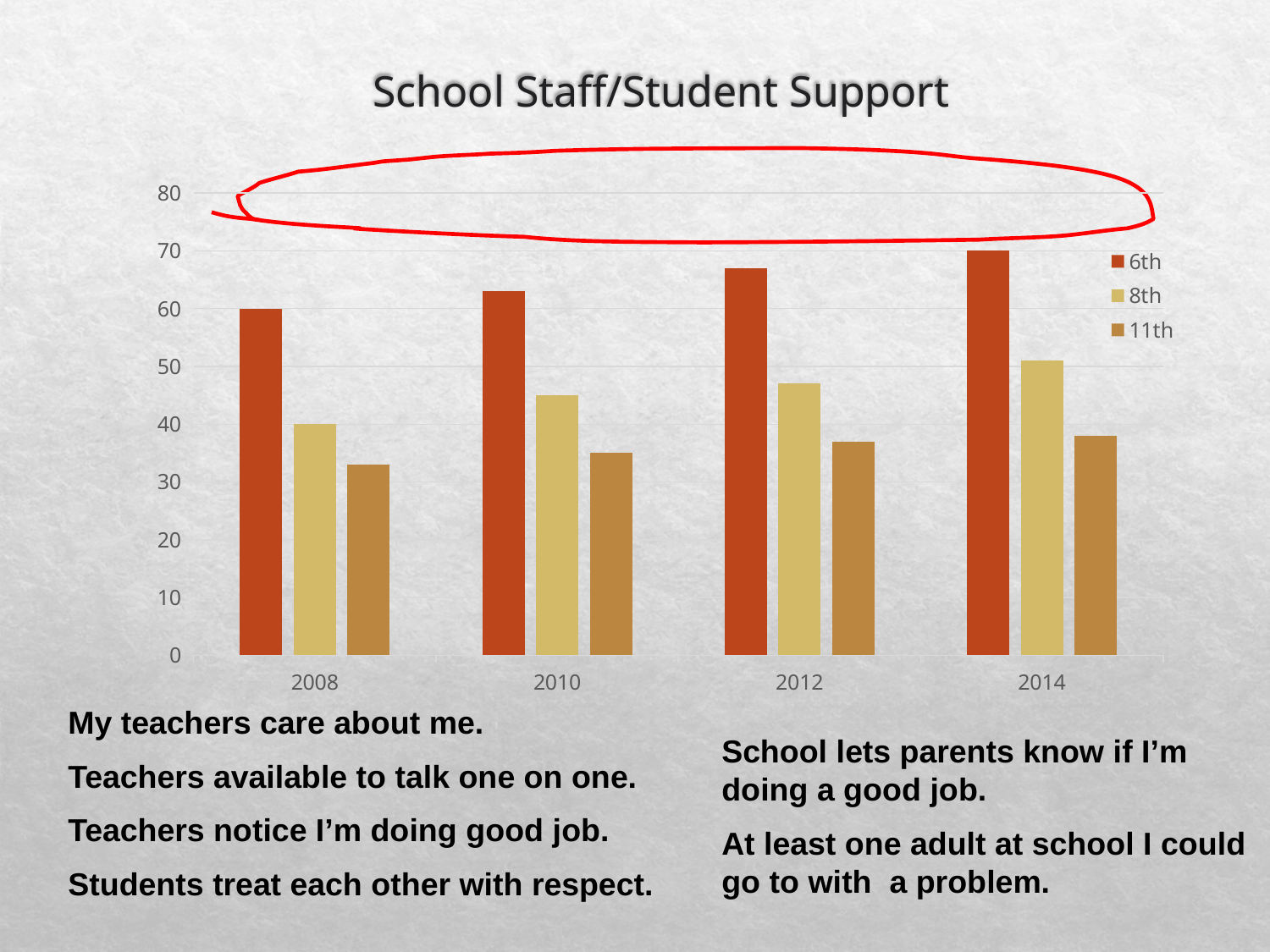
How many series does the legend list? 3 Do the 6th grade values rise or fall from 2008 to 2014? rise What is the title of the chart? School Staff/Student Support Which grade levels are listed in the legend? 6th, 8th, 11th In 2012, which is larger, the 6th grade value or the 8th grade value? 6th How many years are shown on the x axis? 4 In which year is the 6th grade bar the highest? 2014 What kind of chart is shown on the slide? bar chart Is the value for 11th grade in 2010 greater or less than 40? less Is the value for 6th grade in 2012 greater or less than 60? greater In which year is the 11th grade bar the lowest? 2008